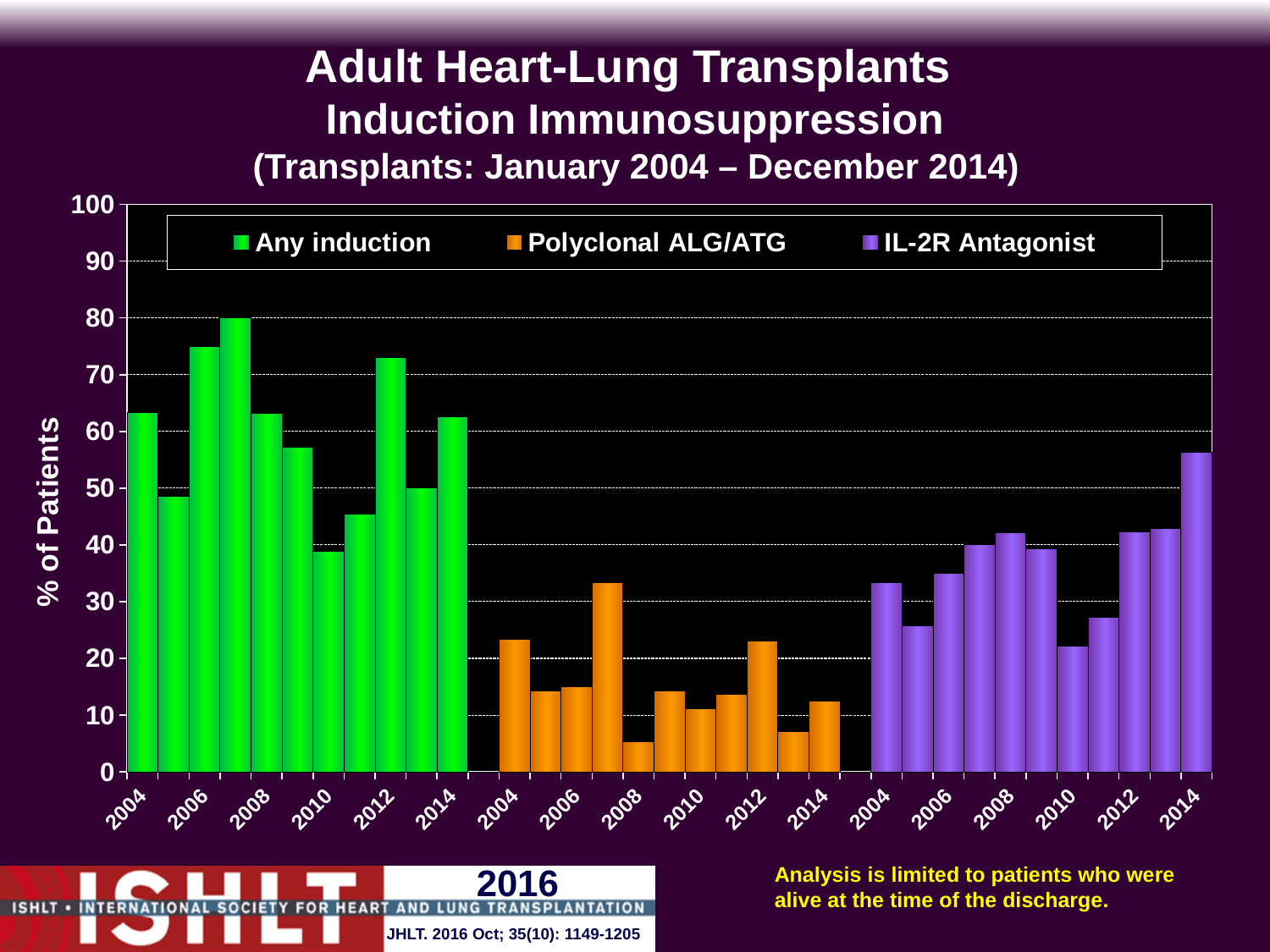
What is the label on the y axis? % of Patients How many series does the legend list? 3 In which year is the Any induction value highest? 2007 In which year is the Any induction value lowest? 2010 In which year is the Polyclonal ALG/ATG value lowest? 2008 In which year is the Polyclonal ALG/ATG value highest? 2007 How many years are plotted for the Any induction series? 11 What kind of chart is shown on the slide? bar chart Is the Any induction value for 2004 greater or less than 60? greater In which year is the IL-2R Antagonist value highest? 2014 Is the IL-2R Antagonist value for 2014 greater or less than 50? greater Which is larger, the Polyclonal ALG/ATG value for 2007 or for 2008? 2007